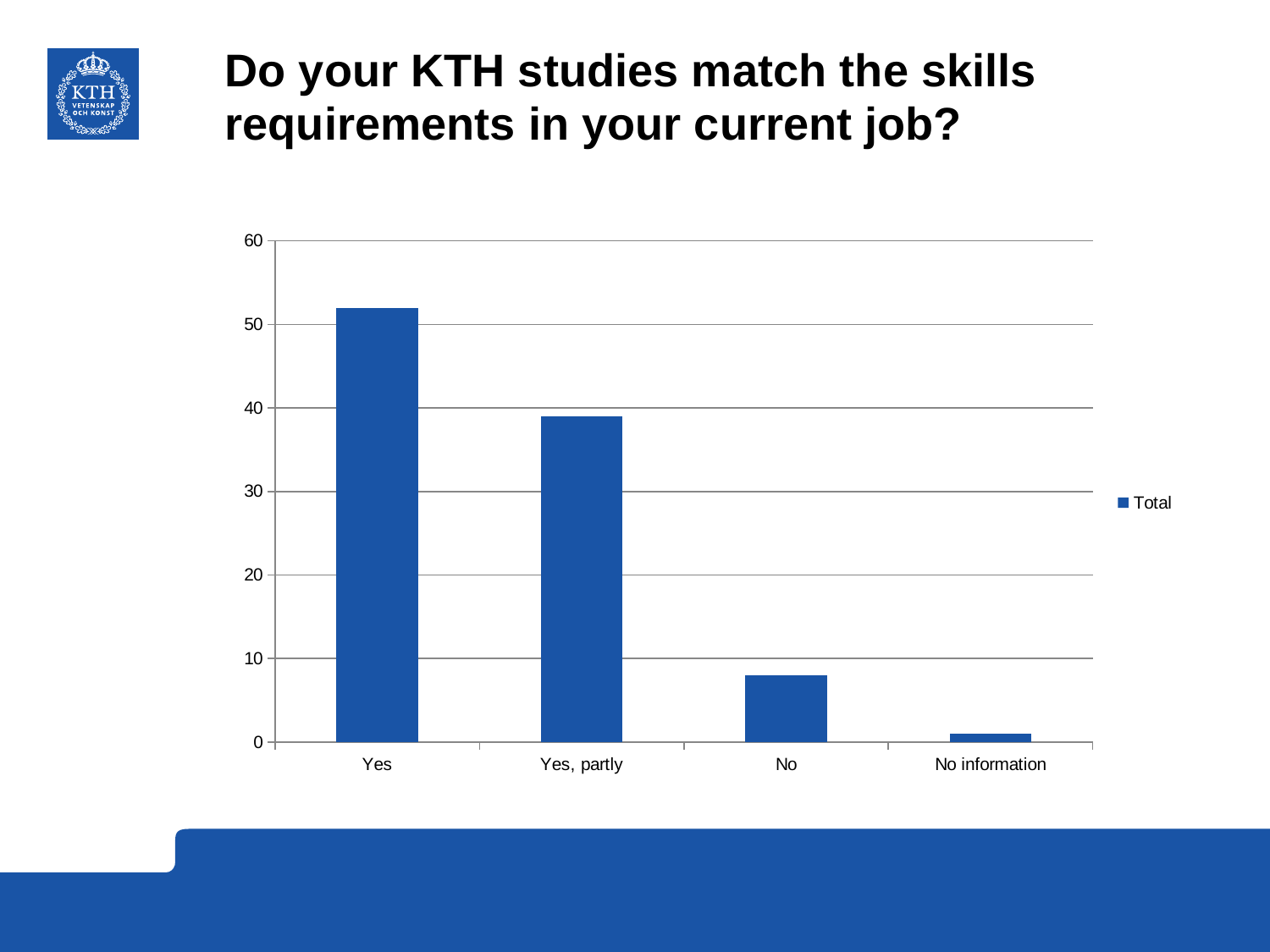
What is the name of the series shown in the chart legend? Total Which is larger, the value for "Yes" or the value for "Yes, partly"? Yes Do the values rise or fall moving from left to right along the x axis? fall Is the value for "Yes" greater or less than 50? greater Is the value for "No" greater or less than 10? less Which is larger, the value for "No" or the value for "No information"? No Is the value for "Yes, partly" greater or less than 30? greater What kind of chart is shown on the slide? bar chart Which category has the highest value in the chart? Yes How many categories are shown on the x axis of the chart? 4 Which category has the lowest value in the chart? No information How many series does the chart legend list? 1